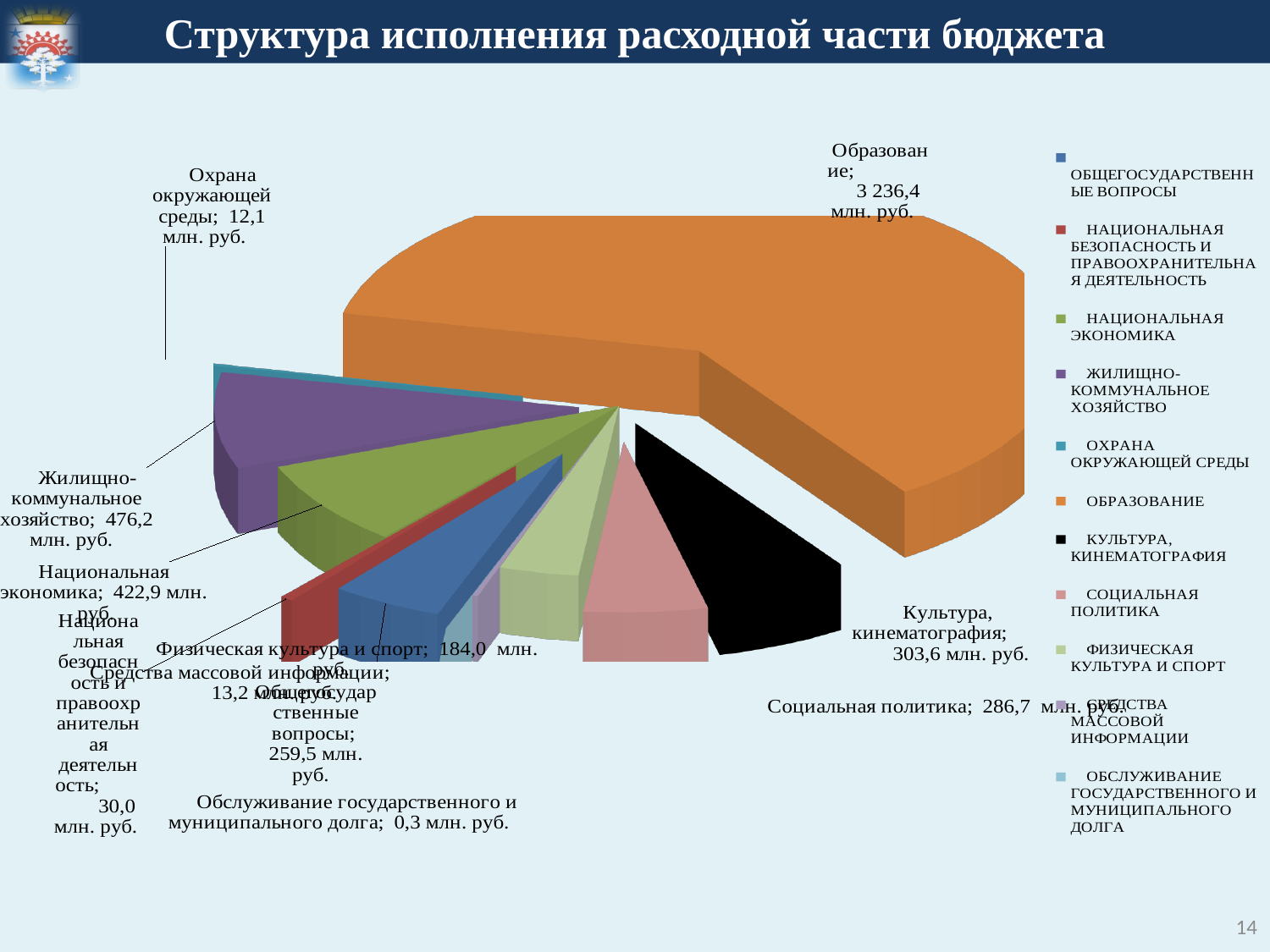
What is the value for Жилищно-коммунальное хозяйство? 476,2 млн. руб. What is the difference between Жилищно-коммунальное хозяйство and Национальная экономика? 53,3 млн. руб. What is the title of the slide? Структура исполнения расходной части бюджета Which category has the smallest value? Обслуживание государственного и муниципального долга Which is larger, Культура, кинематография or Социальная политика? Культура, кинематография What is the difference between Образование and Жилищно-коммунальное хозяйство? 2 760,2 млн. руб. How many categories does the pie chart have? 11 What is the value for Социальная политика? 286,7 млн. руб. What kind of chart is shown on the slide? Pie chart What is the value for Обслуживание государственного и муниципального долга? 0,3 млн. руб. Which category has the largest value? Образование What is the value for Образование? 3 236,4 млн. руб.